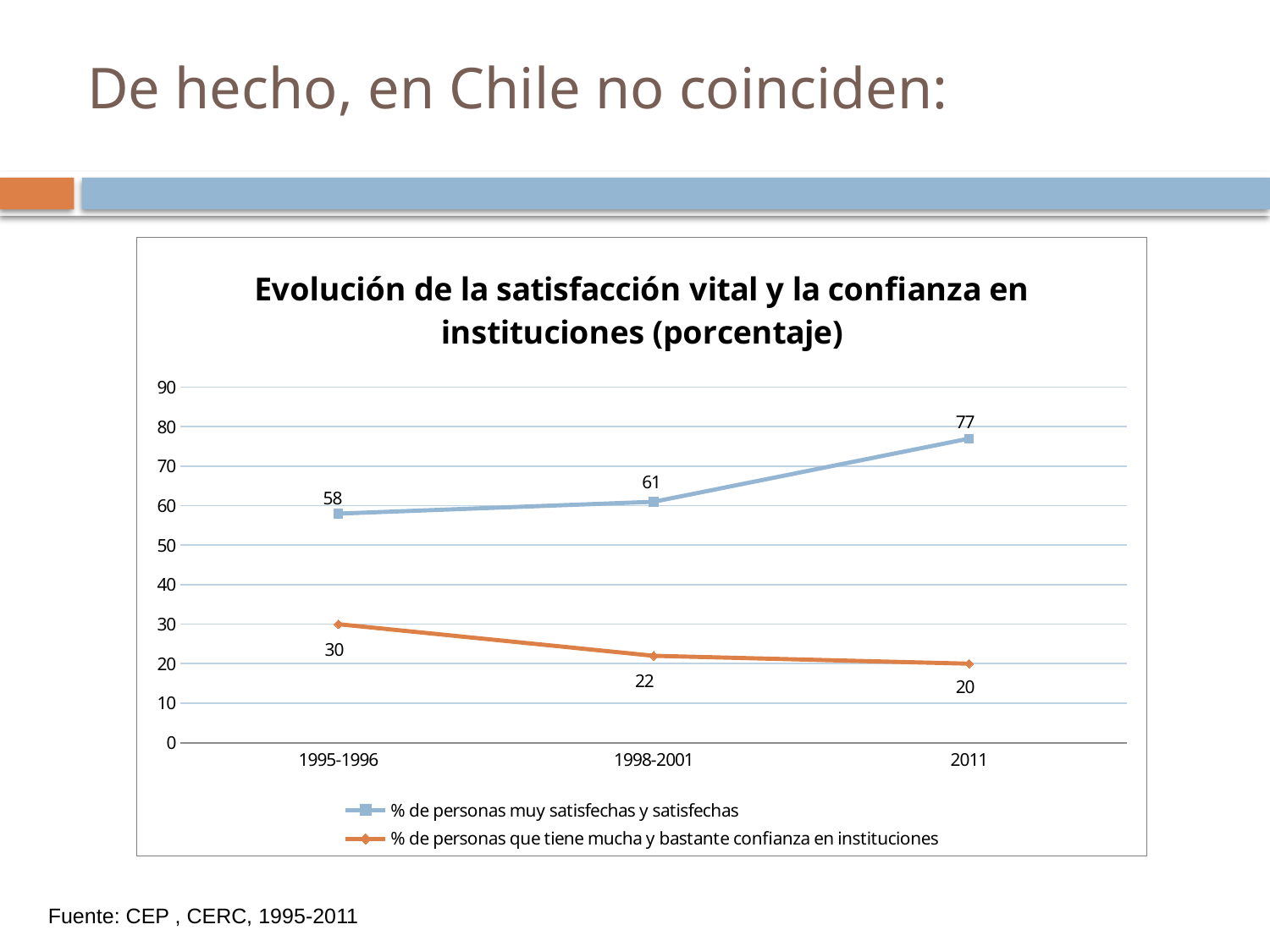
In which period is '% de personas muy satisfechas y satisfechas' highest? 2011 What kind of chart is shown? Line chart In which period is '% de personas que tiene mucha y bastante confianza en instituciones' lowest? 2011 How many periods are shown on the x axis? 3 What is the value for '% de personas muy satisfechas y satisfechas' in 1995-1996? 58 Which series has the larger value in 1998-2001? % de personas muy satisfechas y satisfechas What is the difference between the 1995-1996 and 2011 values for '% de personas muy satisfechas y satisfechas'? 19 What is the value for '% de personas muy satisfechas y satisfechas' in 2011? 77 What is the difference between the two series in 2011? 57 How many series does the legend list? 2 What is the value for '% de personas que tiene mucha y bastante confianza en instituciones' in 1998-2001? 22 Does '% de personas que tiene mucha y bastante confianza en instituciones' rise or fall from 1995-1996 to 2011? Fall